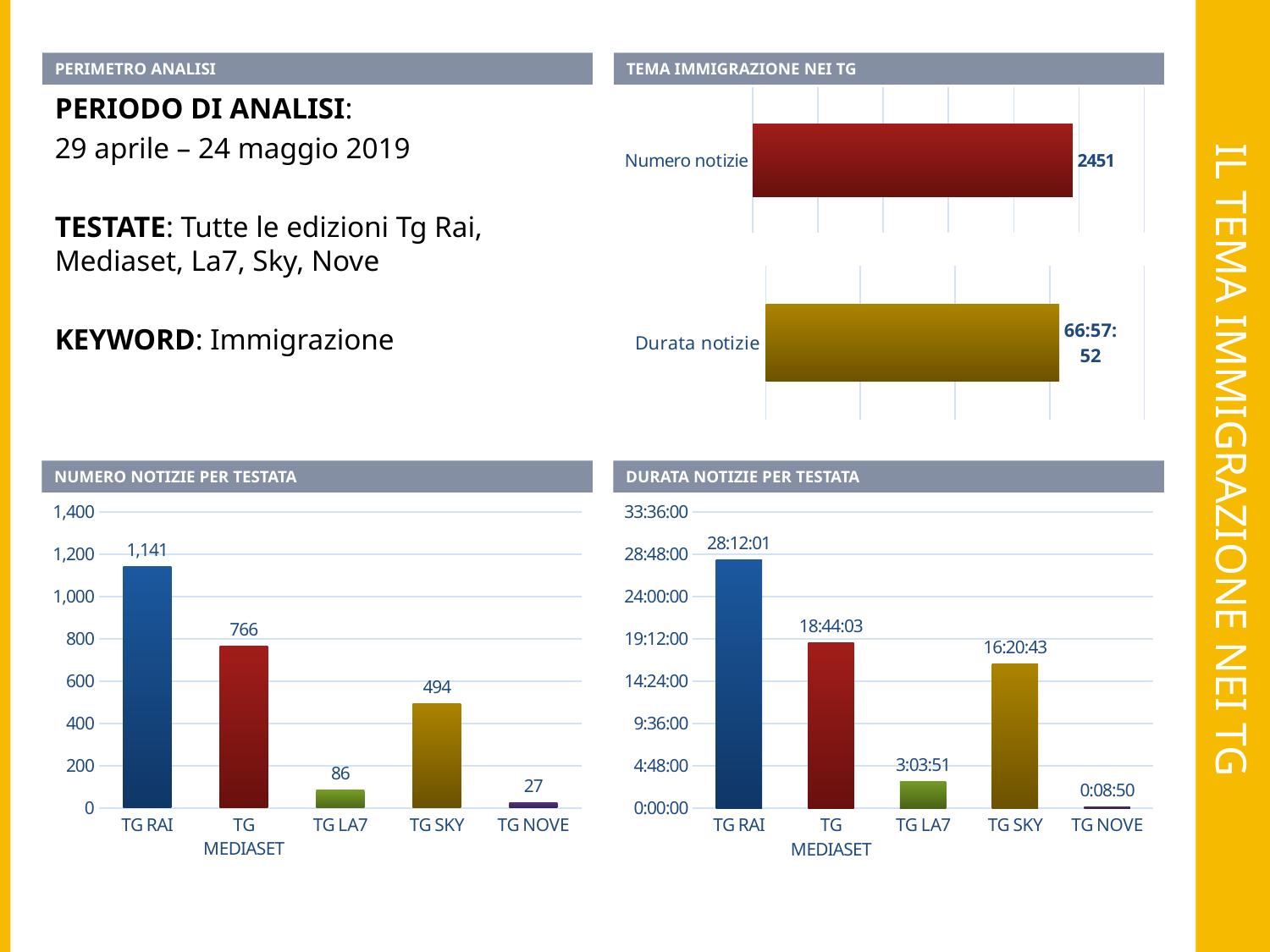
In the 'TEMA IMMIGRAZIONE NEI TG' chart at the top right, what is the value for Durata notizie? 66:57:52 In the 'NUMERO NOTIZIE PER TESTATA' chart, what is the difference between the values for TG RAI and TG SKY? 647 In the 'DURATA NOTIZIE PER TESTATA' chart, which is larger, the value for TG MEDIASET or the value for TG LA7? TG MEDIASET What kind of chart is 'NUMERO NOTIZIE PER TESTATA'? bar chart In the 'TEMA IMMIGRAZIONE NEI TG' chart at the top right, what is the value for Numero notizie? 2451 In the 'NUMERO NOTIZIE PER TESTATA' chart, what is the value for TG MEDIASET? 766 In the 'DURATA NOTIZIE PER TESTATA' chart, is the value for TG RAI greater or less than 24:00:00? greater In the 'NUMERO NOTIZIE PER TESTATA' chart, which testata has the highest number of notizie? TG RAI In the 'NUMERO NOTIZIE PER TESTATA' chart, how many testate are shown on the x axis? 5 In the 'DURATA NOTIZIE PER TESTATA' chart, what is the value for TG SKY? 16:20:43 In the 'NUMERO NOTIZIE PER TESTATA' chart, which testata has the lowest number of notizie? TG NOVE In the 'DURATA NOTIZIE PER TESTATA' chart, what is the value for TG NOVE? 0:08:50